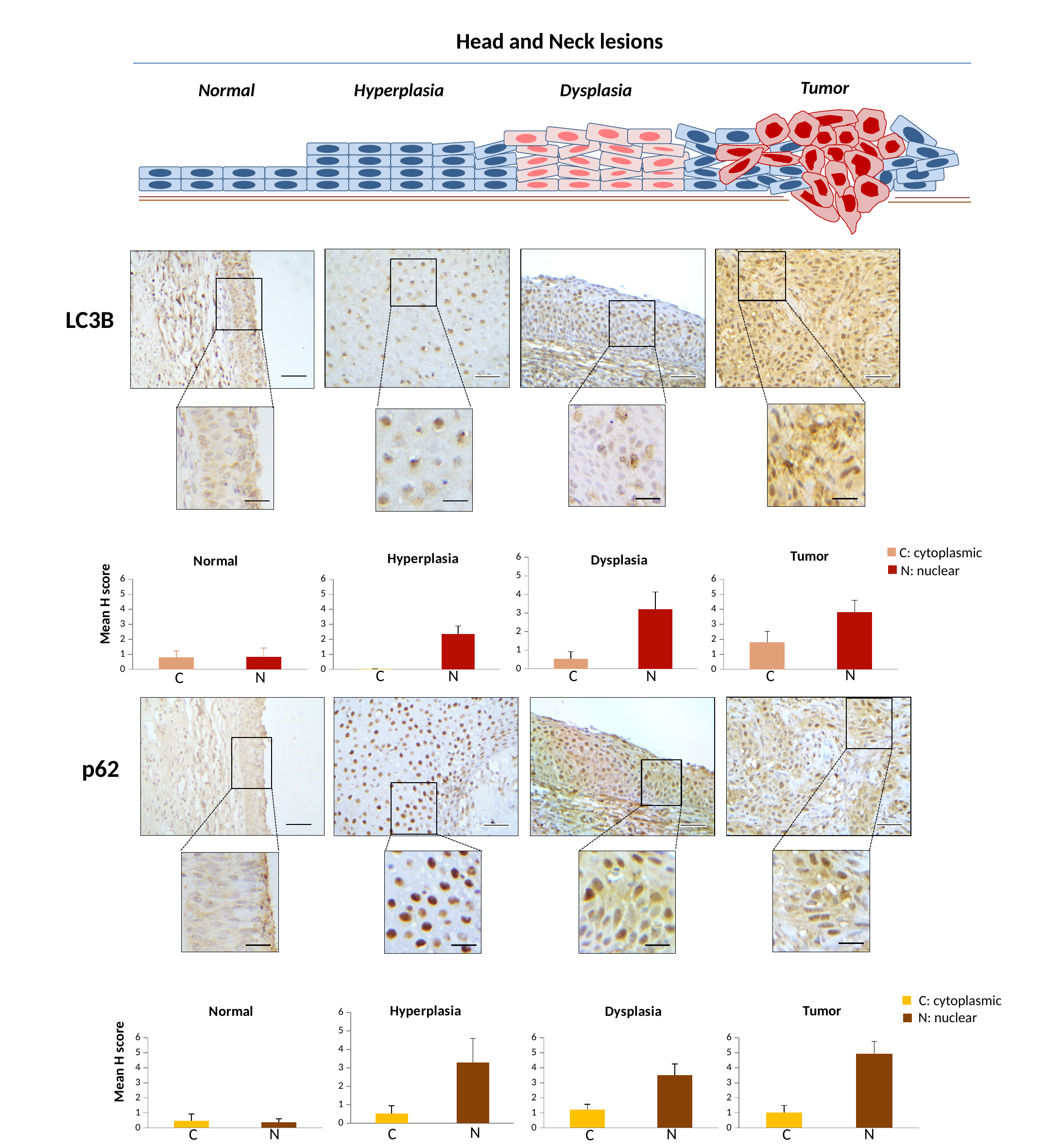
In the legend for the p62 charts, what does N stand for? nuclear What is the y-axis label of the LC3B Normal chart? Mean H score How many bars are shown in the LC3B Normal chart? 2 In the p62 Hyperplasia chart, is the value for C greater or less than 1? less What type of chart is the p62 Tumor chart? bar chart In the LC3B Dysplasia chart, is the value for N greater or less than 2? greater In the LC3B Tumor chart, is the value for C greater or less than 3? less In the LC3B Hyperplasia chart, which bar is taller, C or N? N In the p62 Dysplasia chart, which bar is taller, C or N? N